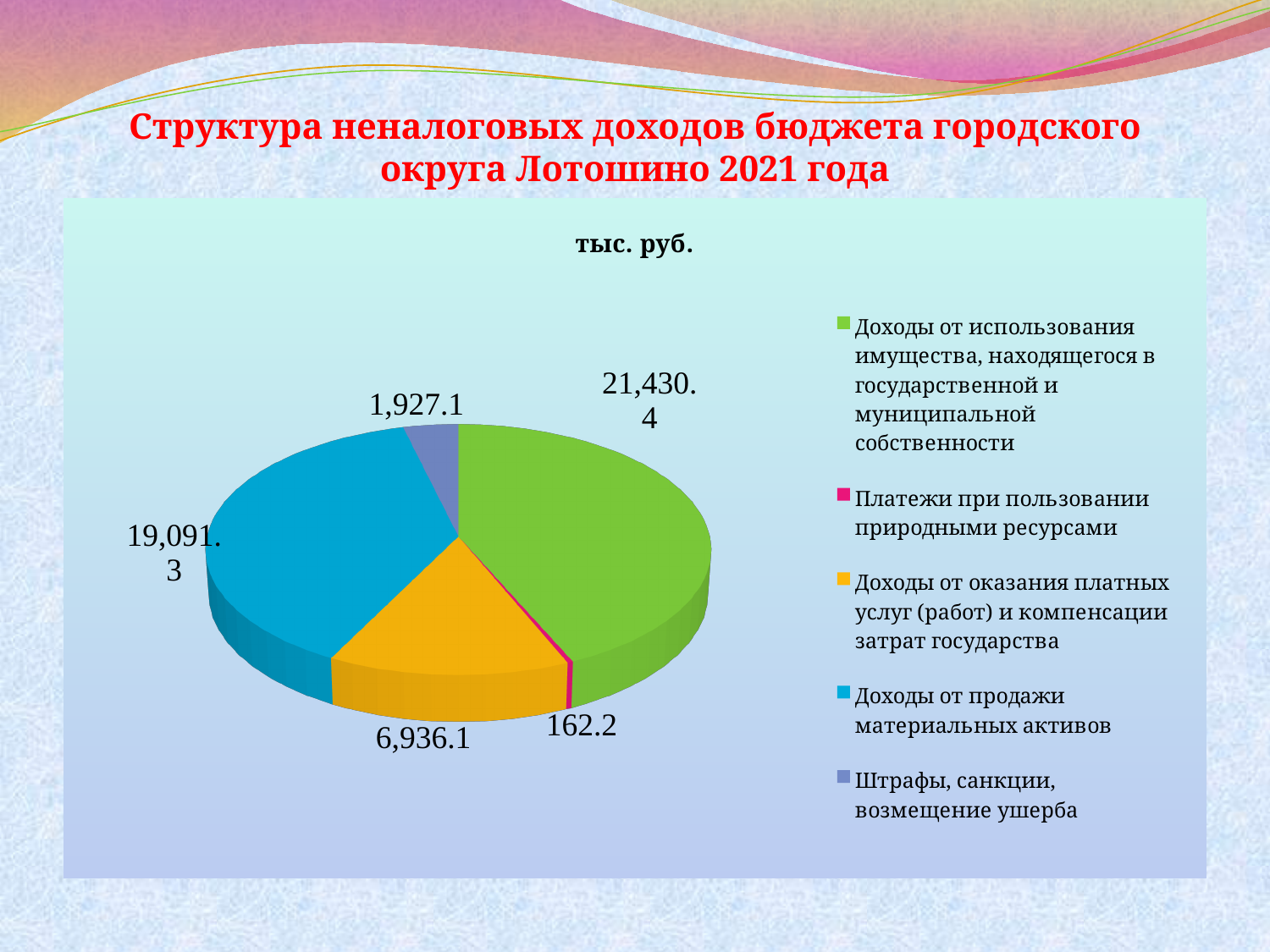
What is the value for "Платежи при пользовании природными ресурсами"? 162.2 What is the value for "Доходы от продажи материальных активов"? 19,091.3 What is the title shown above the pie chart? тыс. руб. How many categories does the pie chart have? 5 What type of chart is shown on the slide? Pie chart What is the value for "Штрафы, санкции, возмещение ущерба"? 1,927.1 What is the value for "Доходы от использования имущества, находящегося в государственной и муниципальной собственности"? 21,430.4 Which category has the smallest slice of the pie? Платежи при пользовании природными ресурсами What is the difference between the values for "Доходы от использования имущества" and "Доходы от продажи материальных активов"? 2,339.1 Which category has the largest slice of the pie? Доходы от использования имущества, находящегося в государственной и муниципальной собственности What is the total of all slices in the pie chart? 49,547.1 Which is larger: "Доходы от оказания платных услуг (работ) и компенсации затрат государства" or "Штрафы, санкции, возмещение ущерба"? Доходы от оказания платных услуг (работ) и компенсации затрат государства